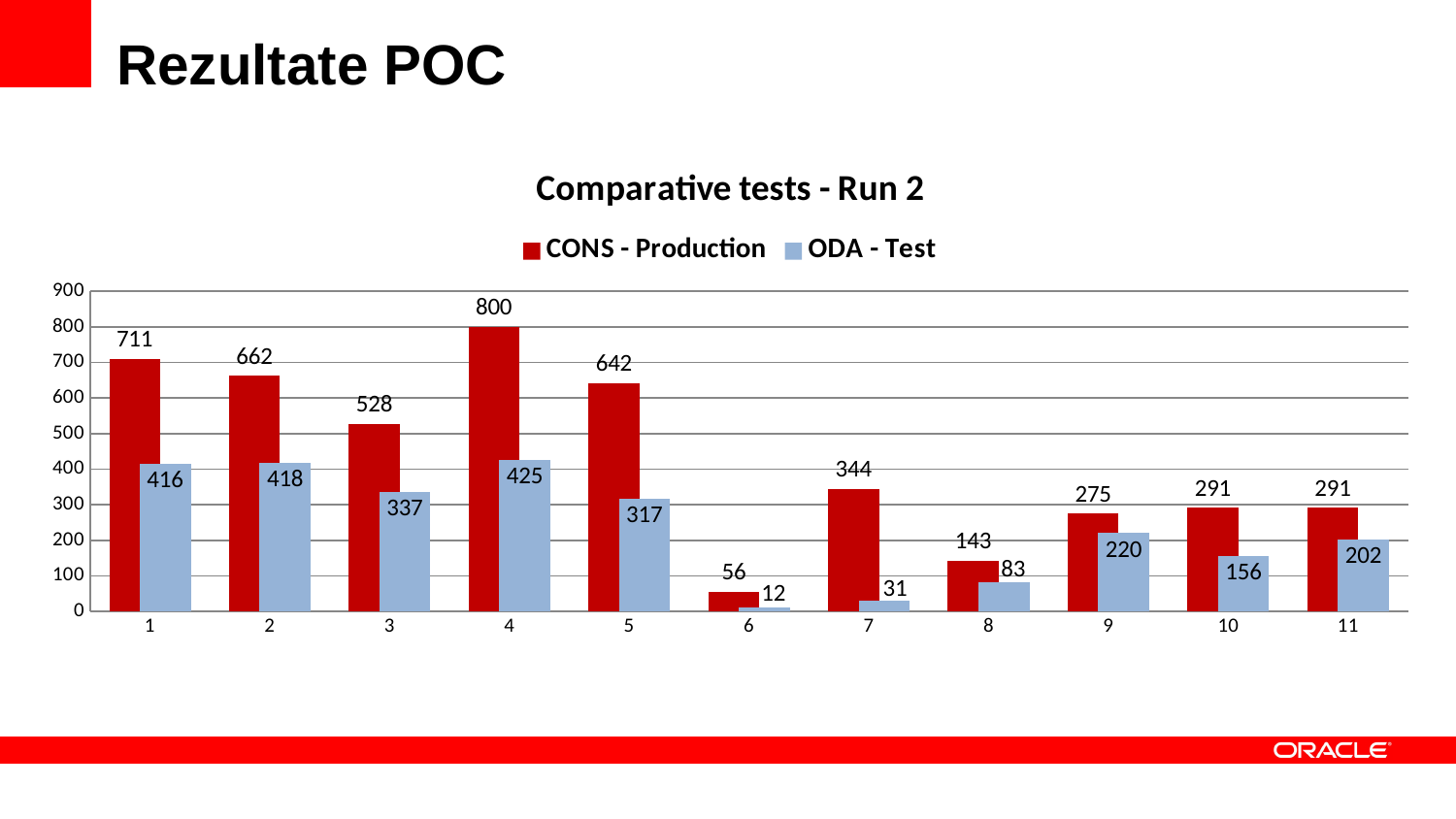
What is the title of the chart? Comparative tests - Run 2 What colour represents the ODA - Test series? Light blue What is the CONS - Production value for category 4? 800 Is the ODA - Test value for category 9 greater or less than 200? greater How many categories are shown on the x axis? 11 Which is larger for category 5: CONS - Production or ODA - Test? CONS - Production What kind of chart is shown on the slide? Bar chart How many series does the legend list? 2 What is the ODA - Test value for category 7? 31 What is the difference between CONS - Production and ODA - Test for category 1? 295 Which category has the lowest ODA - Test value? 6 Which category has the highest CONS - Production value? 4